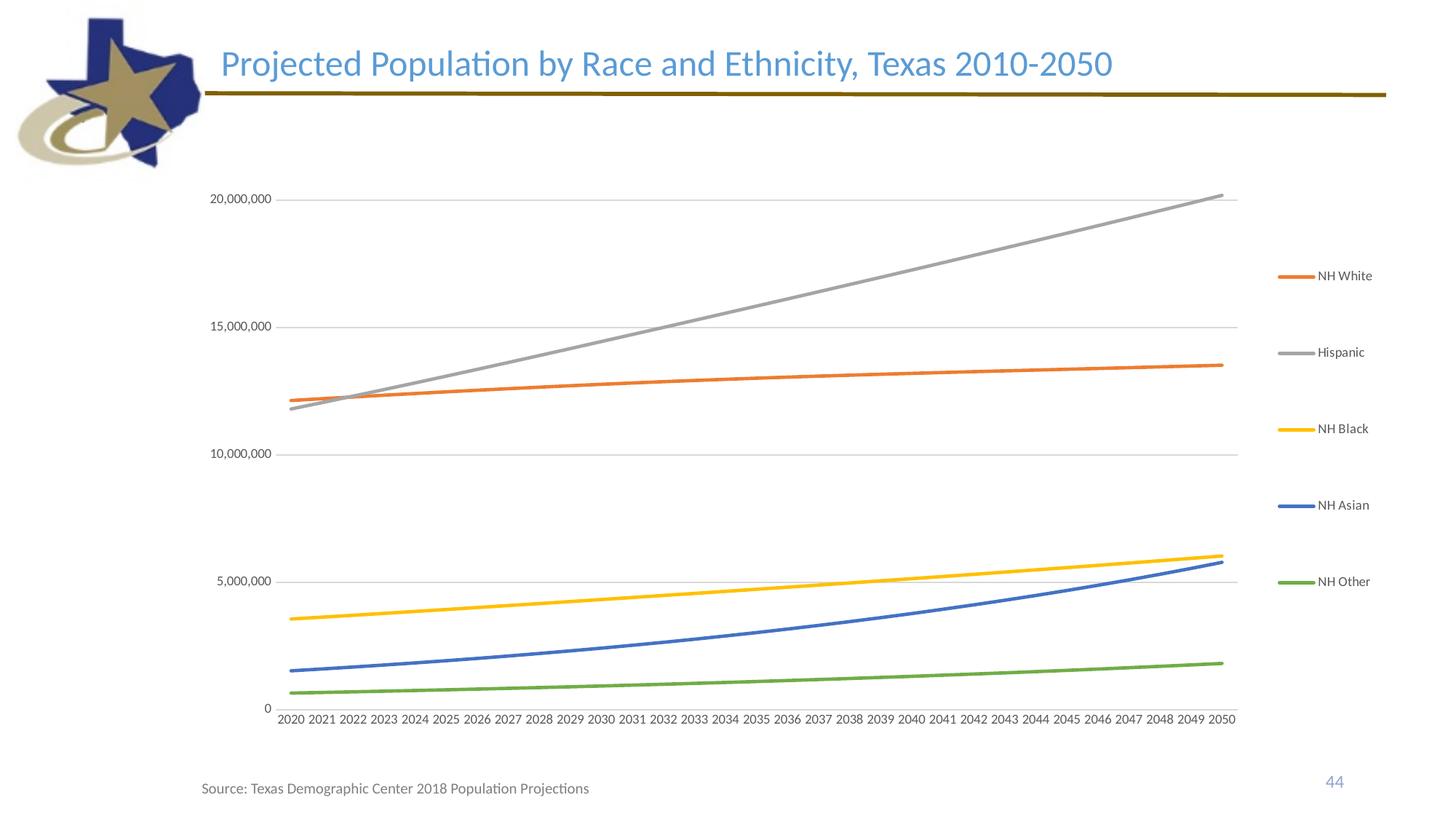
What colour is the Hispanic line in the legend? Gray Is the value for Hispanic in 2020 greater or less than 15,000,000? less Which series has the lowest value in 2050? NH Other Is the value for NH Other in 2050 greater or less than 5,000,000? less Which series has the highest value in 2050? Hispanic How many years are shown along the x axis? 31 How many series does the legend list? 5 What kind of chart is shown on the slide? Line chart Is the value for NH Black in 2050 greater or less than 5,000,000? greater In 2050, which is larger: NH White or Hispanic? Hispanic Does the Hispanic line rise or fall from 2020 to 2050? Rise